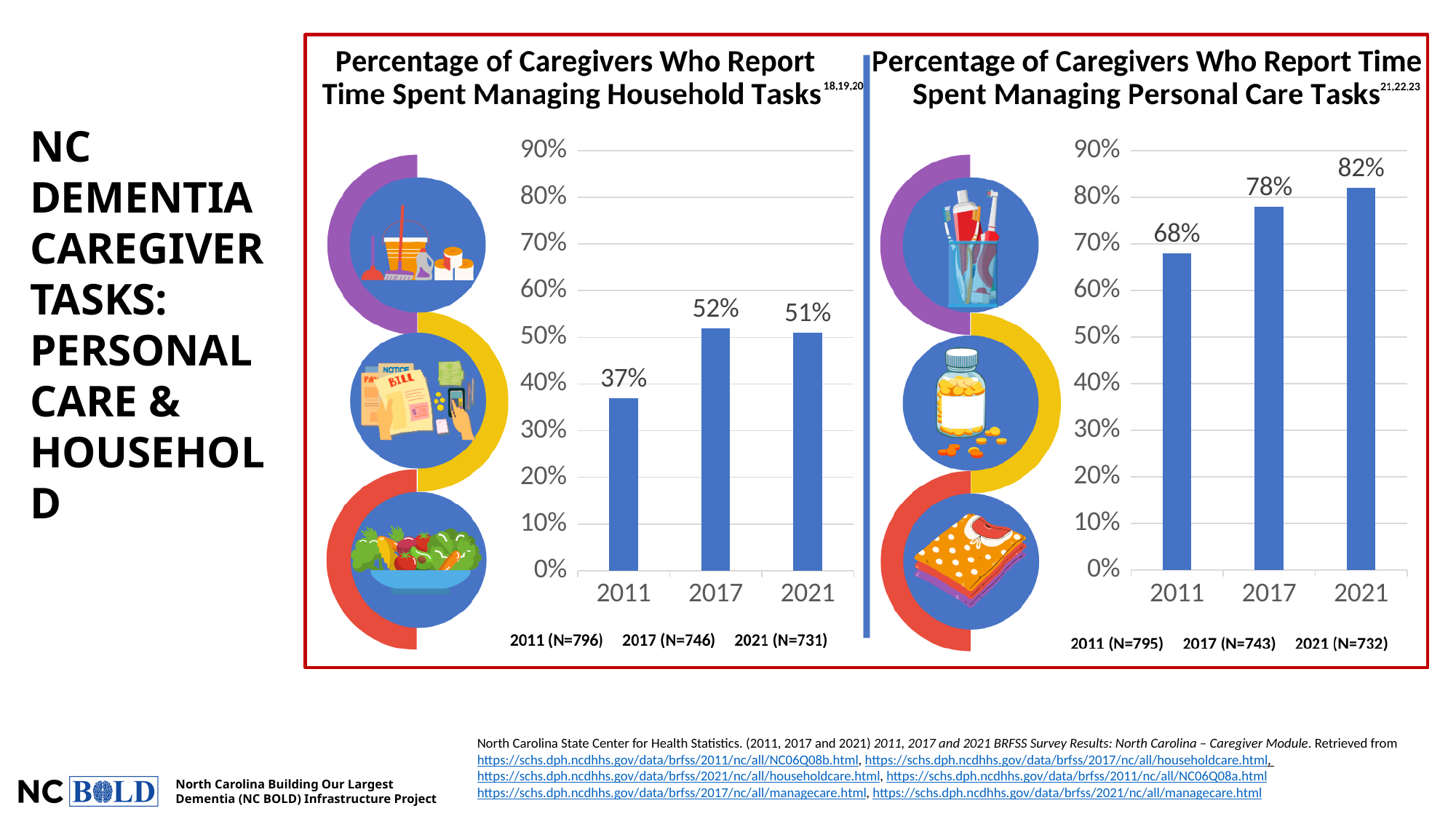
In the Household Tasks chart, which year has the highest value? 2017 In the Personal Care Tasks chart, what is the difference between the 2021 and 2011 values? 14% In the Personal Care Tasks chart, do the values rise or fall from 2011 to 2021? rise In the Household Tasks chart, what percentage of caregivers reported time spent managing household tasks in 2011? 37% In the Personal Care Tasks chart, which year has the lowest value? 2011 What kind of chart is the Personal Care Tasks chart? bar chart In the Household Tasks chart, what is the value for 2017? 52% In the Personal Care Tasks chart, is the value for 2017 larger or smaller than the value for 2011? larger In the Personal Care Tasks chart, what is the value for 2021? 82% In the Personal Care Tasks chart, what is the value for 2011? 68% How many years are plotted in the Household Tasks chart? 3 In the Household Tasks chart, what is the difference between the 2017 and 2011 values? 15%